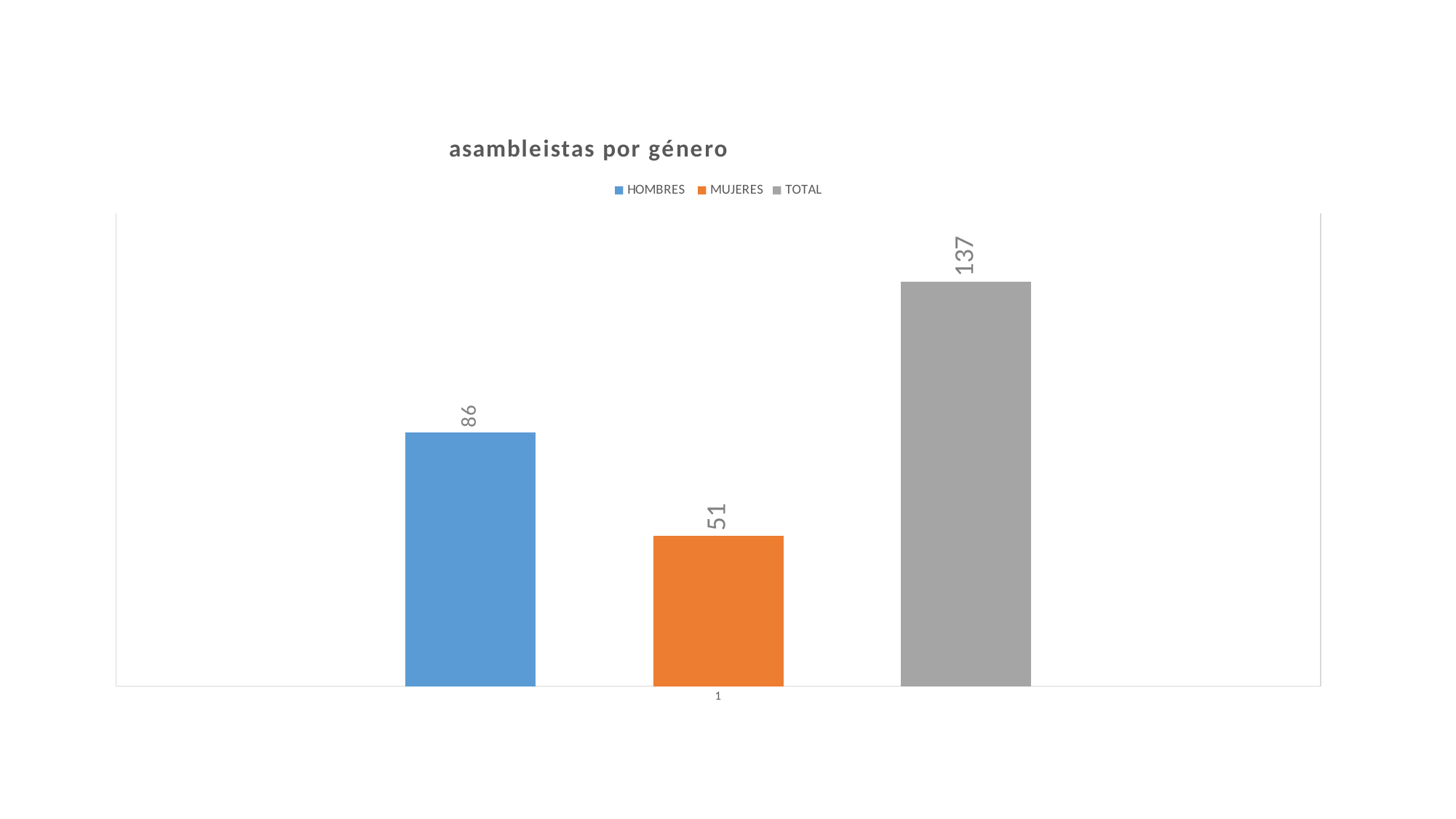
What colour is the bar for MUJERES? orange What is the title of the chart? asambleistas por género How many series does the legend list? 3 What kind of chart is shown? bar chart What is the value for HOMBRES? 86 Which series has the lowest value? MUJERES What is the value for TOTAL? 137 Which series has the highest value? TOTAL What is the value for MUJERES? 51 Which is larger, HOMBRES or MUJERES? HOMBRES What is the difference between the HOMBRES and MUJERES values? 35 What is the difference between the TOTAL and HOMBRES values? 51